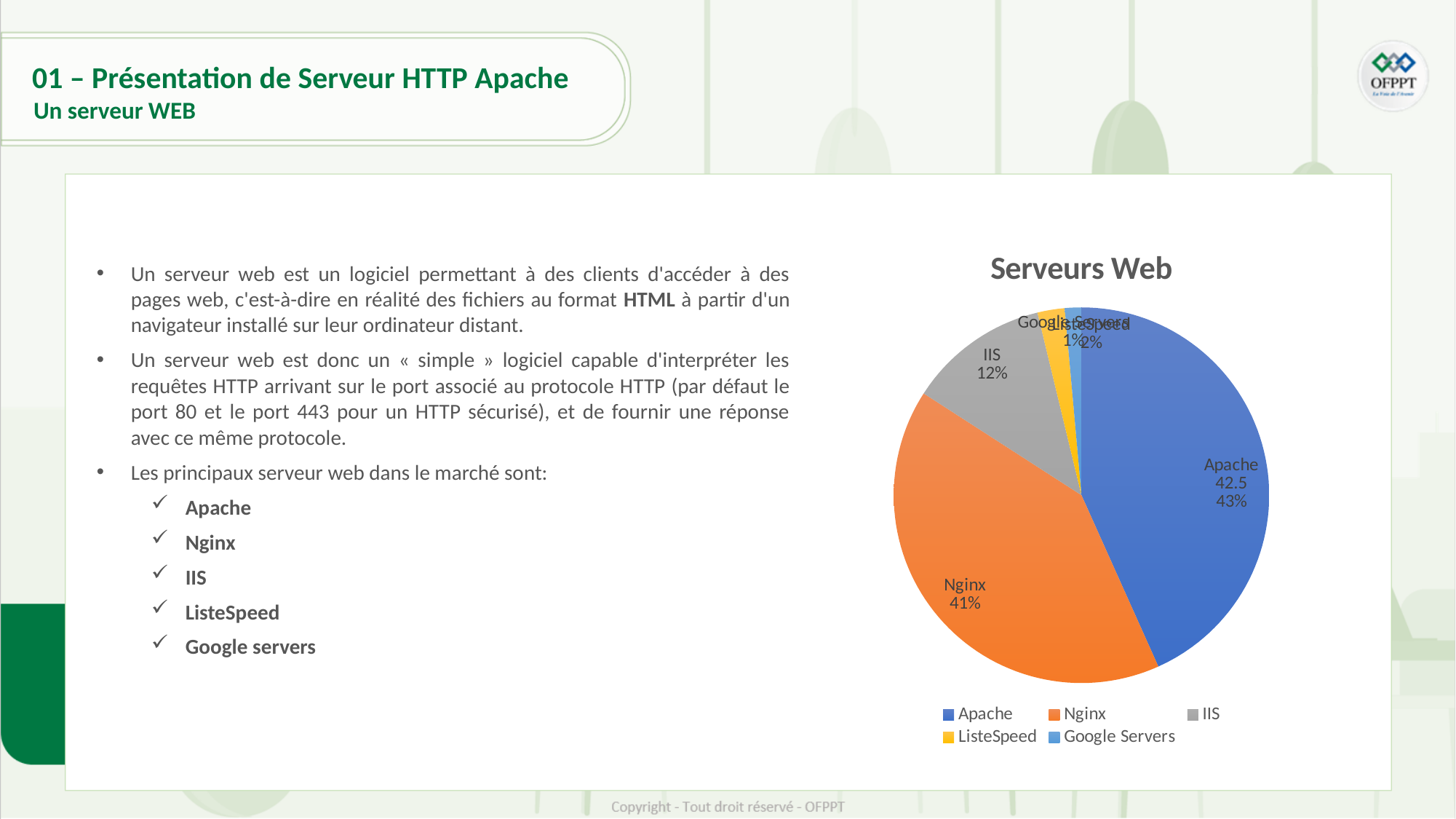
Which web server has the smallest slice of the pie chart? Google Servers By how many percentage points does Apache's share exceed Nginx's share? 2 percentage points Which web server has the largest slice of the pie chart? Apache What kind of chart is shown on the slide? pie chart How many slices does the pie chart have? 5 By how many percentage points does Nginx's share exceed IIS's share? 29 percentage points What percentage share does Nginx have in the pie chart? 41% What percentage share does Apache have in the pie chart? 43% What is the title of the chart? Serveurs Web What colour is the Nginx slice in the pie chart? orange What percentage share does IIS have in the pie chart? 12% Which has a larger share, Apache or Nginx? Apache